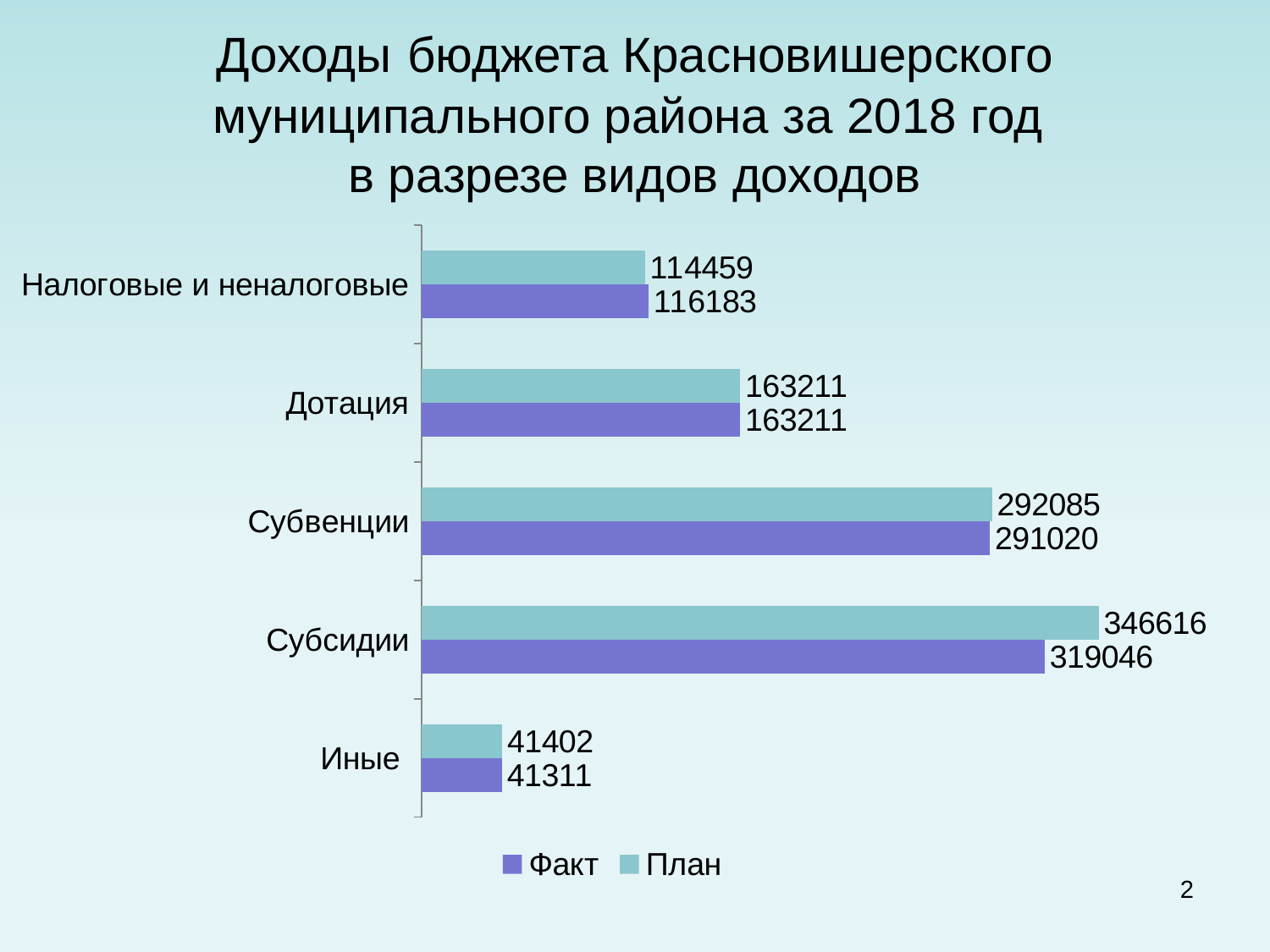
What kind of chart is shown on the slide? Bar chart What is the difference between the Факт values for Субвенции and Дотация? 127809 Which category has the highest Факт value? Субсидии Which series is shown in purple? Факт What is the План value for Субсидии? 346616 What is the Факт value for Налоговые и неналоговые? 116183 What is the Факт value for Иные? 41311 How many categories are shown on the chart? 5 How many series does the legend list? 2 Which category has the lowest План value? Иные Which is larger for Налоговые и неналоговые: the План value or the Факт value? Факт What is the difference between the План and Факт values for Субсидии? 27570